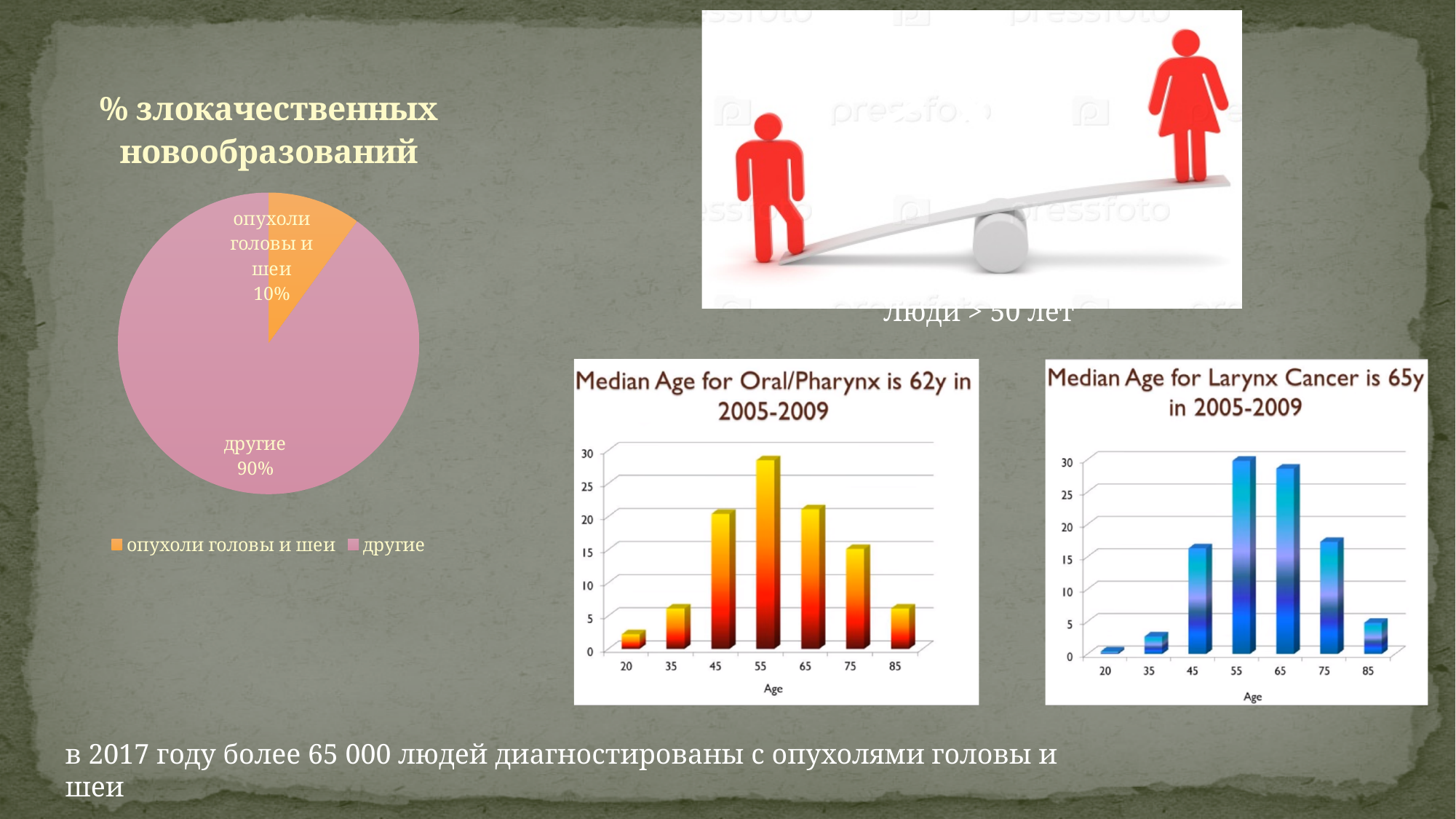
In the chart 'Median Age for Larynx Cancer is 65y in 2005-2009', which age group has the lowest bar? 20 In the chart 'Median Age for Oral/Pharynx is 62y in 2005-2009', which age group has the lowest bar? 20 In the chart 'Median Age for Oral/Pharynx is 62y in 2005-2009', which age group has the highest bar? 55 In the chart 'Median Age for Oral/Pharynx is 62y in 2005-2009', is the value for age 45 greater or less than 15? greater In the pie chart '% злокачественных новообразований', what share is labelled 'другие'? 90% How many entries does the legend of the pie chart '% злокачественных новообразований' list? 2 In the pie chart '% злокачественных новообразований', what colour is the 'опухоли головы и шеи' slice? Orange In the chart 'Median Age for Larynx Cancer is 65y in 2005-2009', is the value for age 85 greater or less than 10? less What kind of chart is 'Median Age for Oral/Pharynx is 62y in 2005-2009'? Bar chart In the pie chart '% злокачественных новообразований', which slice is larger: 'опухоли головы и шеи' or 'другие'? другие In the pie chart '% злокачественных новообразований', what share is labelled 'опухоли головы и шеи'? 10% How many age groups are shown on the x axis of the chart 'Median Age for Larynx Cancer is 65y in 2005-2009'? 7